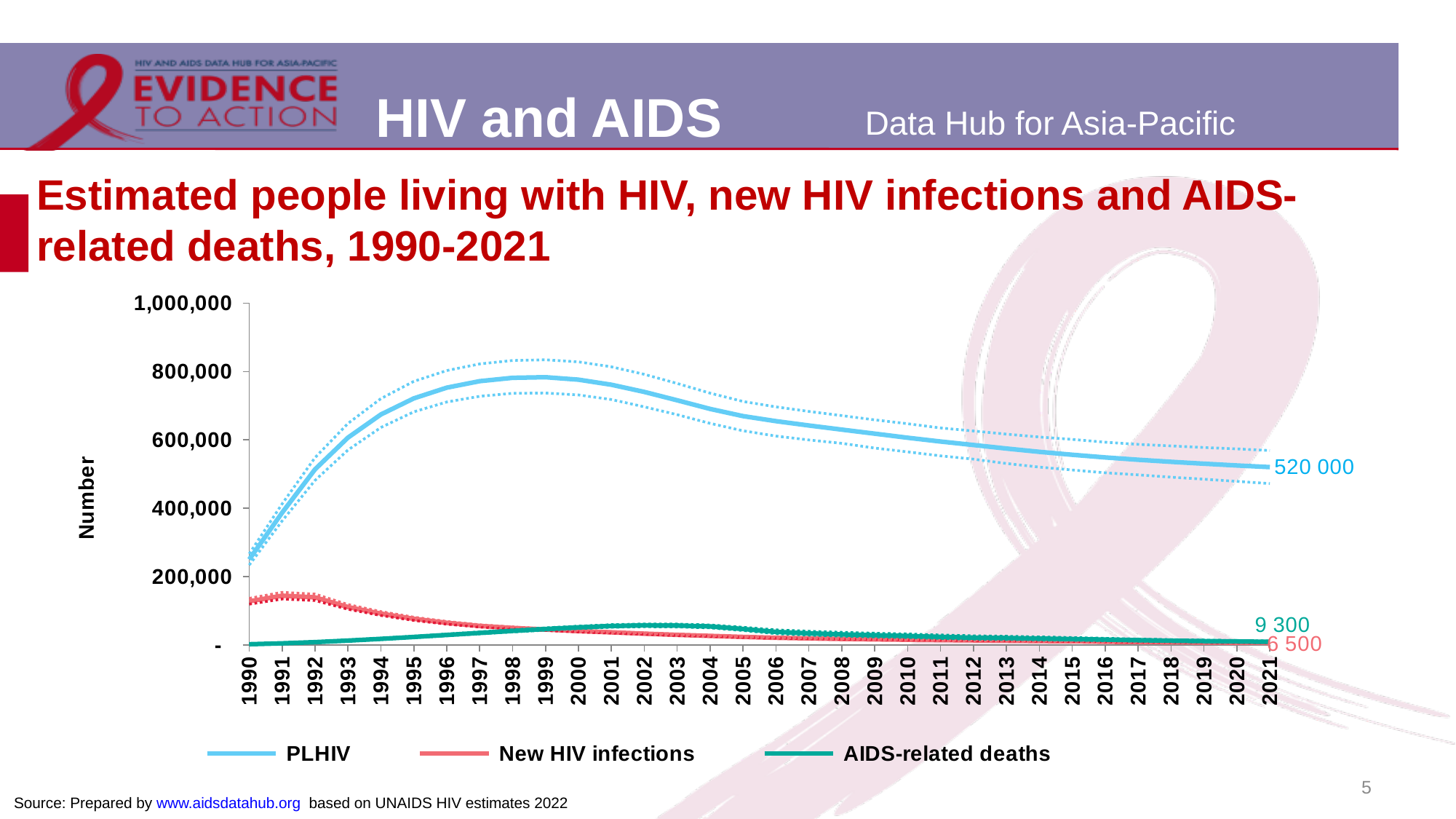
What is the difference between AIDS-related deaths and New HIV infections in 2021? 2 800 How many series does the legend list? 3 What kind of chart is shown on the slide? line chart Does the PLHIV line rise or fall from 2000 to 2021? fall In 2021, which is larger: AIDS-related deaths or New HIV infections? AIDS-related deaths Which series has the highest value in 2021? PLHIV What is the value for AIDS-related deaths in 2021? 9 300 Is the value for PLHIV in 1999 greater or less than 600,000? greater What is the value for New HIV infections in 2021? 6 500 Is the value for PLHIV in 1990 greater or less than 400,000? less What is the label on the vertical axis? Number What is the value for PLHIV in 2021? 520 000